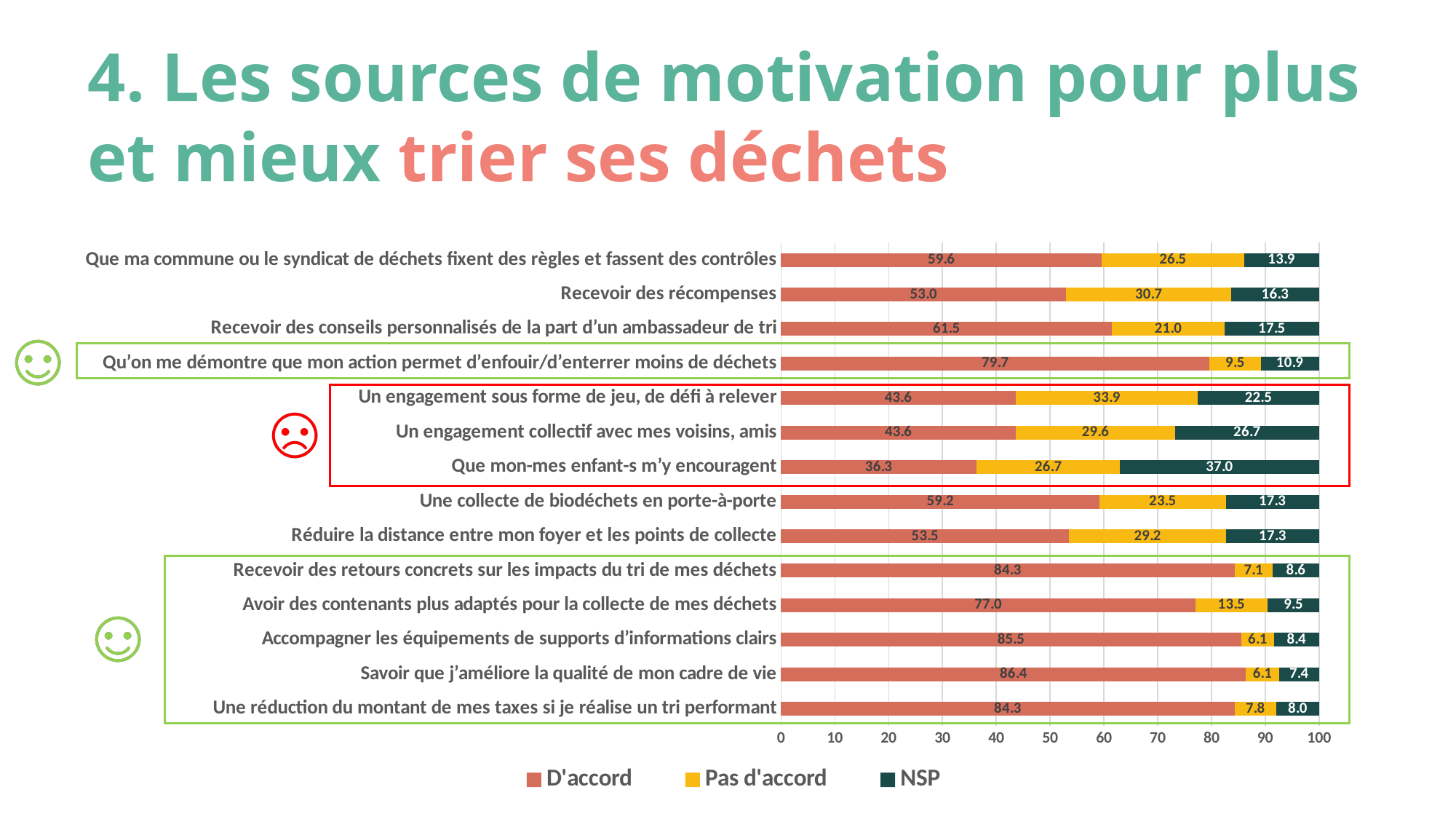
Which is larger: the 'D'accord' value for 'Avoir des contenants plus adaptés pour la collecte de mes déchets' or for 'Qu'on me démontre que mon action permet d'enfouir/d'enterrer moins de déchets'? Qu'on me démontre que mon action permet d'enfouir/d'enterrer moins de déchets How many series does the legend list? 3 How many categories (motivation sources) are plotted in the chart? 14 Which category has the highest 'D'accord' value? Savoir que j'améliore la qualité de mon cadre de vie What is the difference between the highest 'D'accord' value (86.4) and the lowest 'D'accord' value (36.3)? 50.1 What is the total of the stacked bar for 'Recevoir des récompenses'? 100.0 What is the 'D'accord' value for 'Recevoir des récompenses'? 53.0 What is the 'Pas d'accord' value for 'Un engagement sous forme de jeu, de défi à relever'? 33.9 Which legend entry is shown in yellow? Pas d'accord What kind of chart is shown on the slide? Stacked bar chart Which category has the lowest 'D'accord' value? Que mon-mes enfant-s m'y encouragent What is the 'NSP' value for 'Que mon-mes enfant-s m'y encouragent'? 37.0